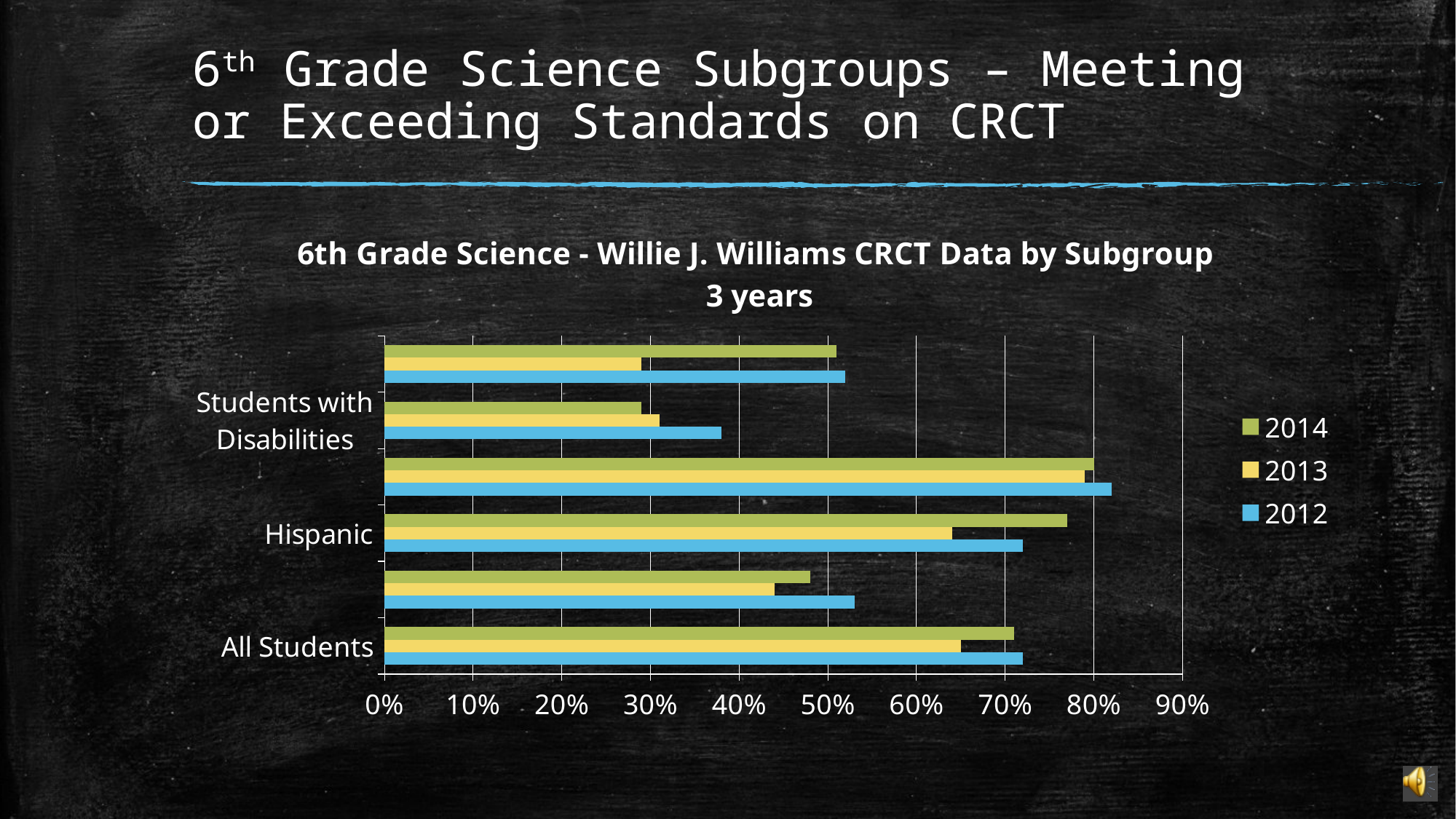
Which years are listed in the chart legend? 2014, 2013, 2012 How many series does the legend list? 3 Is the 2014 value for Students with Disabilities greater or less than 40%? less Is the 2014 value for Hispanic greater or less than 70%? greater Is the 2013 value for Hispanic greater or less than 60%? greater What kind of chart is shown on the slide? bar chart What is the title of the chart? 6th Grade Science - Willie J. Williams CRCT Data by Subgroup 3 years For Hispanic, which year has the lowest value? 2013 For Students with Disabilities, which is larger, the 2012 value or the 2014 value? 2012 For Hispanic, which is larger, the 2014 value or the 2013 value? 2014